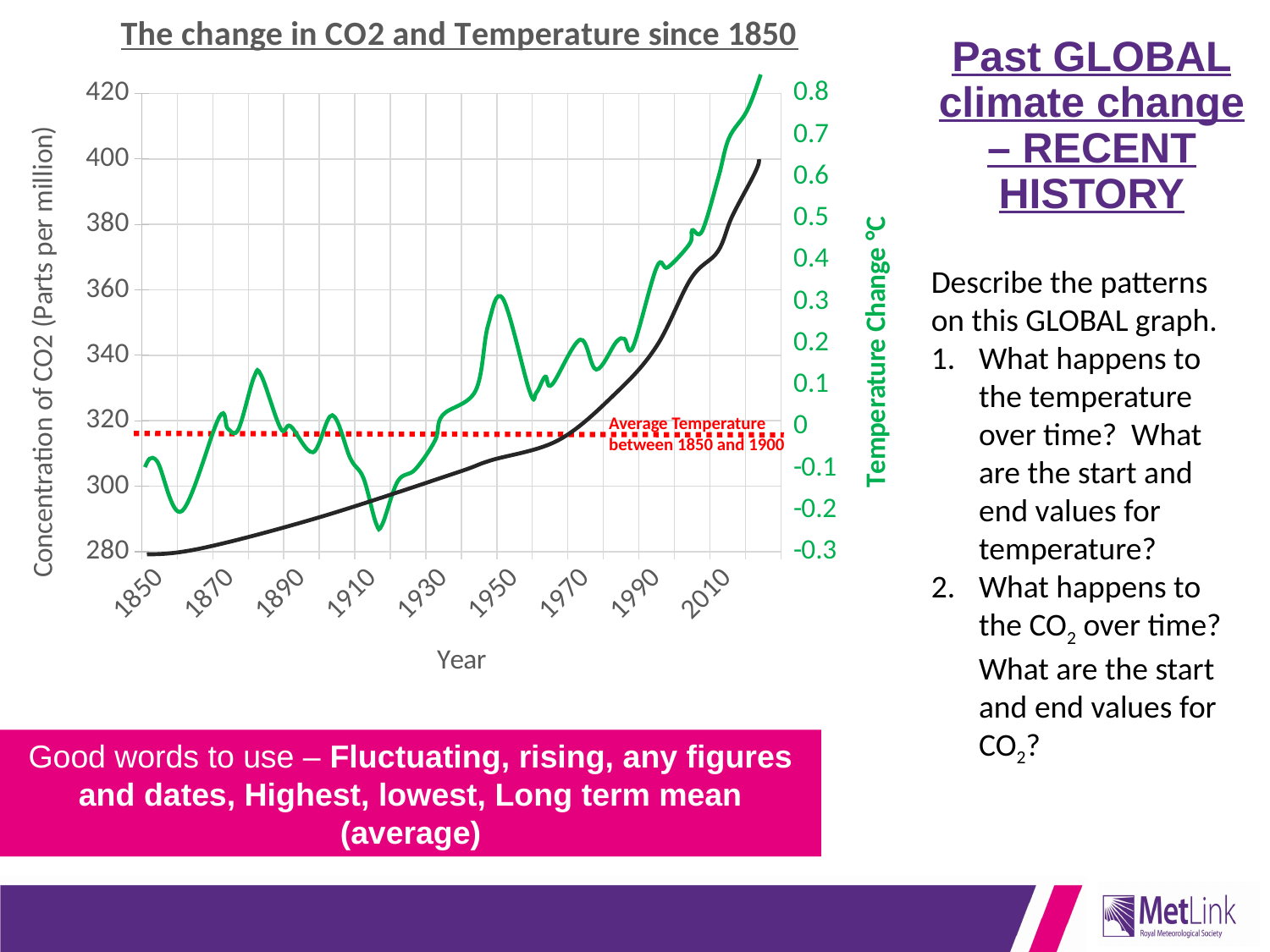
Which is larger, the CO2 concentration in 1850 or in 2010? 2010 What is the title of the chart? The change in CO2 and Temperature since 1850 Is the CO2 concentration in 1850 greater or less than 300 parts per million? less Which is larger, the temperature change at the start of the chart (1850) or at the end of the chart? At the end of the chart Is the temperature change in 1910 greater or less than 0 °C? less Is the temperature change in 2010 greater or less than 0.5 °C? greater Does the CO2 concentration (black line) rise or fall over time from 1850 to the end of the chart? Rise What kind of chart is shown on the slide? Line chart How many year labels are shown on the x axis? 9 What is the label of the right-hand vertical axis? Temperature Change °C